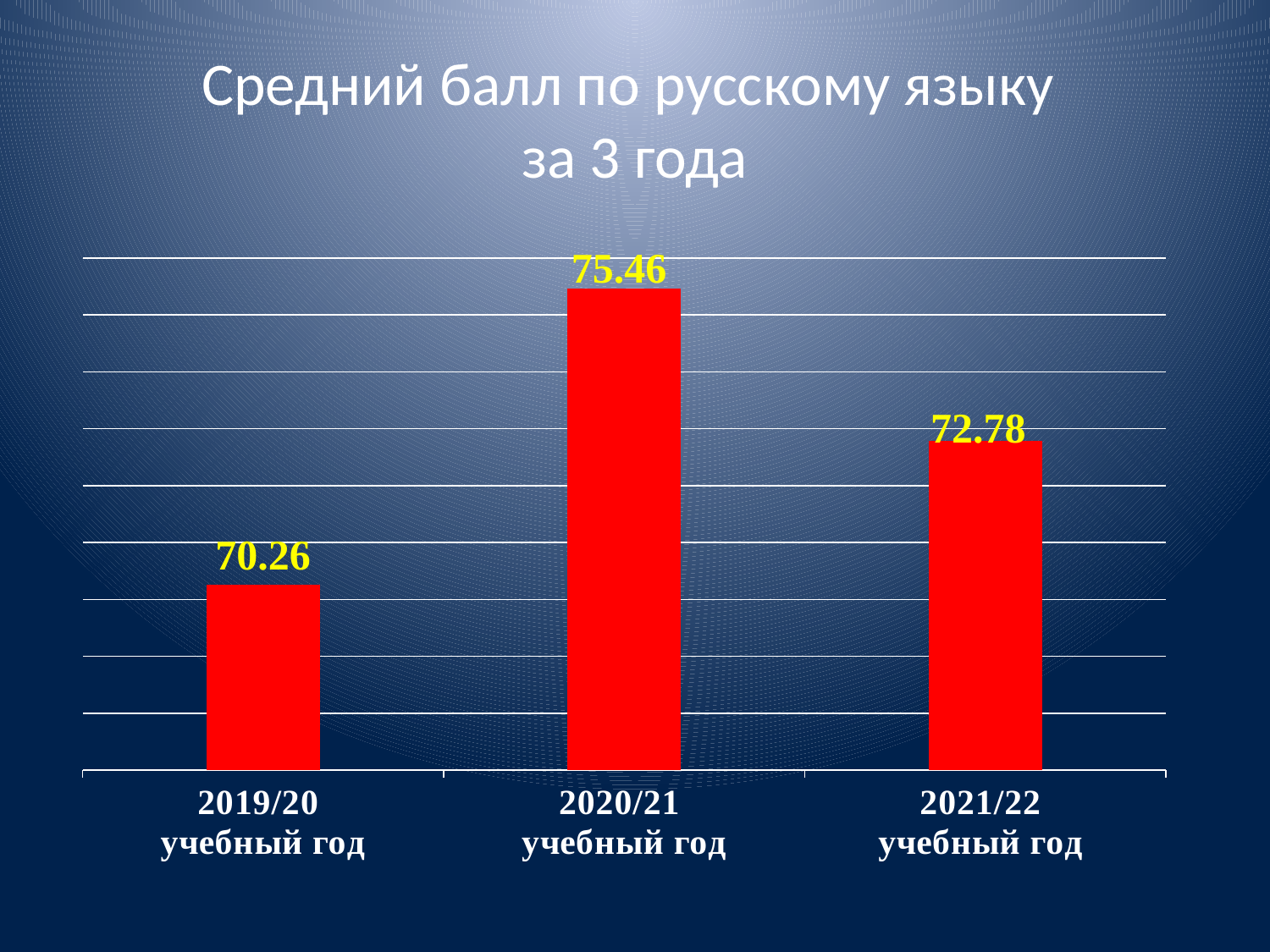
What is the difference between the average scores for 2020/21 and 2019/20? 5.20 Which academic year has the highest average score? 2020/21 учебный год What is the title of the slide? Средний балл по русскому языку за 3 года What kind of chart is shown on the slide? Bar chart What is the average score for the 2020/21 учебный год? 75.46 What is the difference between the average scores for 2020/21 and 2021/22? 2.68 What is the difference between the average scores for 2021/22 and 2019/20? 2.52 How many academic years are shown in the chart? 3 What is the average score for the 2021/22 учебный год? 72.78 Which academic year has the lowest average score? 2019/20 учебный год What is the average score for the 2019/20 учебный год? 70.26 Which is larger, the average score for 2021/22 or for 2019/20? 2021/22